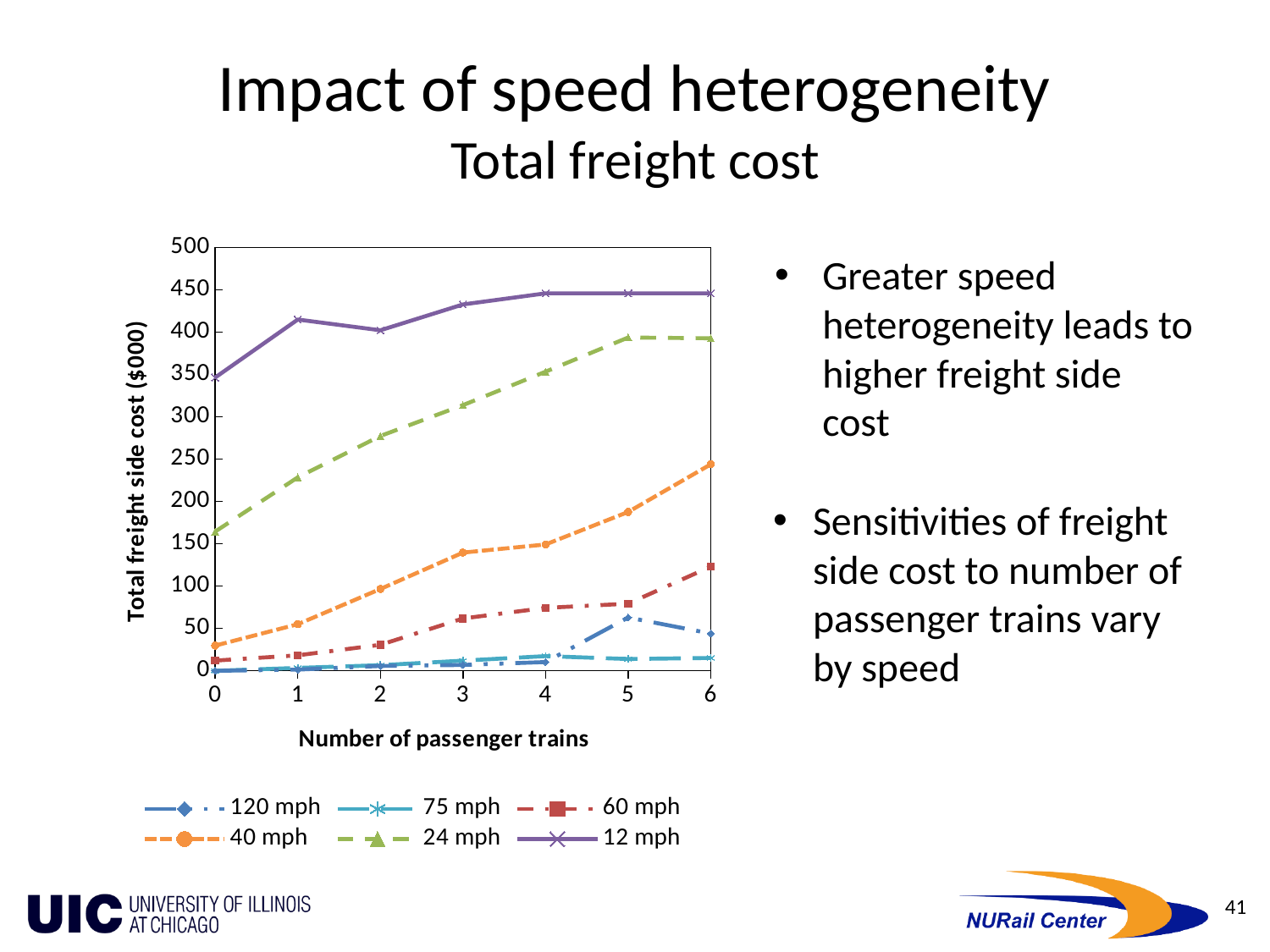
Is the value for 40 mph at 6 passenger trains greater or less than 200? greater Which speed series has the lowest total freight side cost at 6 passenger trains? 75 mph Which speed series has the highest total freight side cost at 6 passenger trains? 12 mph How many series does the legend list? 6 How many values of number of passenger trains are plotted along the x axis? 7 Is the value for 12 mph at 0 passenger trains greater or less than 300? greater What is the title of the y axis? Total freight side cost ($000) Is the value for 60 mph at 6 passenger trains greater or less than 100? greater At 5 passenger trains, which is larger: the value for 120 mph or the value for 75 mph? 120 mph What kind of chart is shown on the slide? line chart Does the 24 mph series rise or fall as the number of passenger trains increases from 0 to 5? rise